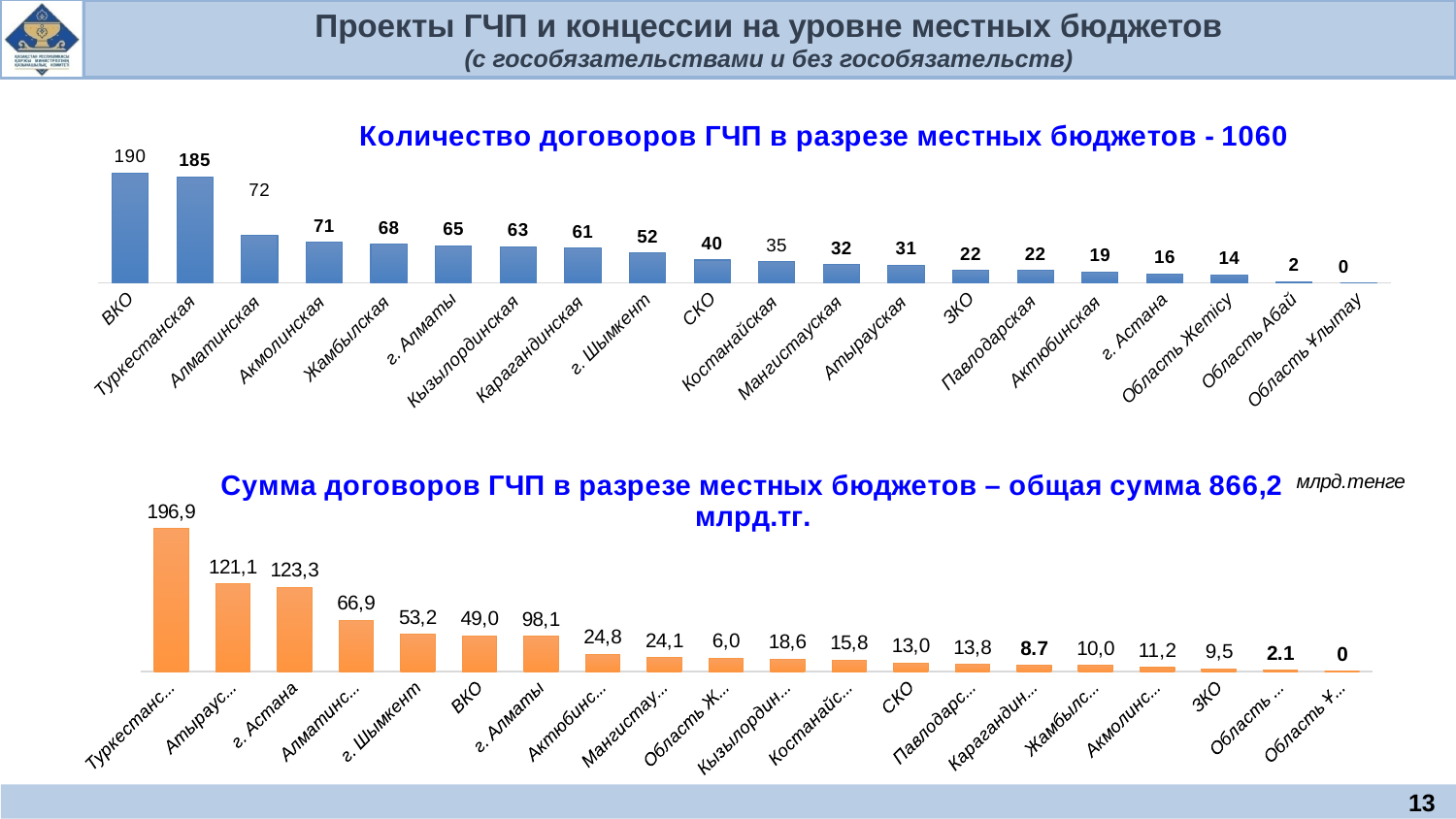
In the top chart 'Количество договоров ГЧП в разрезе местных бюджетов', which category has the lowest value? Область Ұлытау In the top chart 'Количество договоров ГЧП в разрезе местных бюджетов', which is larger, the value for СКО or the value for ЗКО? СКО In the bottom chart 'Сумма договоров ГЧП в разрезе местных бюджетов', what is the value for г. Алматы? 98,1 In the top chart 'Количество договоров ГЧП в разрезе местных бюджетов', how many categories are shown? 20 In the top chart 'Количество договоров ГЧП в разрезе местных бюджетов', which category has the highest value? ВКО In the bottom chart 'Сумма договоров ГЧП в разрезе местных бюджетов', what is the value for г. Астана? 123,3 In the bottom chart 'Сумма договоров ГЧП в разрезе местных бюджетов', what is the difference between the values for г. Шымкент and ВКО? 4,2 In the top chart 'Количество договоров ГЧП в разрезе местных бюджетов', what is the value for г. Шымкент? 52 According to the title of the top chart, what is the total number of ГЧП contracts across local budgets? 1060 In the top chart 'Количество договоров ГЧП в разрезе местных бюджетов', what is the value for ВКО? 190 What type of chart is the bottom chart 'Сумма договоров ГЧП в разрезе местных бюджетов'? Bar chart In the top chart 'Количество договоров ГЧП в разрезе местных бюджетов', what is the difference between the values for ВКО and Туркестанская? 5